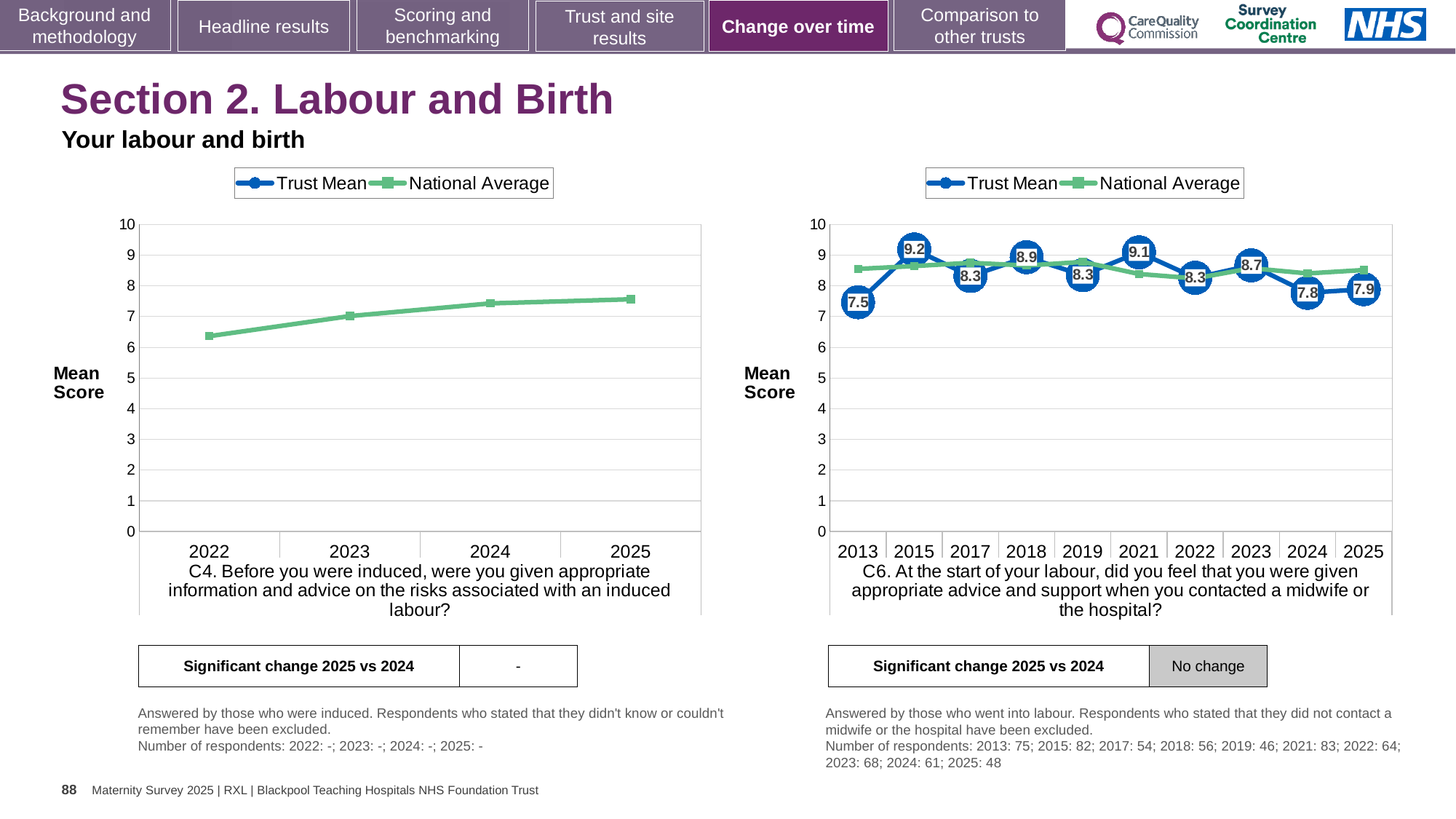
On the C4 chart (left), does the National Average line rise or fall from 2022 to 2025? rise On the C6 chart (right), how many years are shown on the x axis? 10 On the C6 chart (right), what is the Trust Mean score for 2013? 7.5 On the C6 chart (right), is the Trust Mean score higher in 2018 or in 2024? 2018 On the C6 chart (right), which year has the lowest Trust Mean score? 2013 How many series does the legend of the C4 chart (left) list? 2 On the C4 chart (left), is the National Average value for 2022 greater or less than 7? less On the C6 chart (right), which year has the highest Trust Mean score? 2015 On the C6 chart (right), what is the Trust Mean score for 2025? 7.9 What type of chart is the C6 chart (right)? line chart On the C6 chart (right), what is the Trust Mean score for 2015? 9.2 On the C6 chart (right), what is the difference between the Trust Mean scores for 2015 and 2013? 1.7